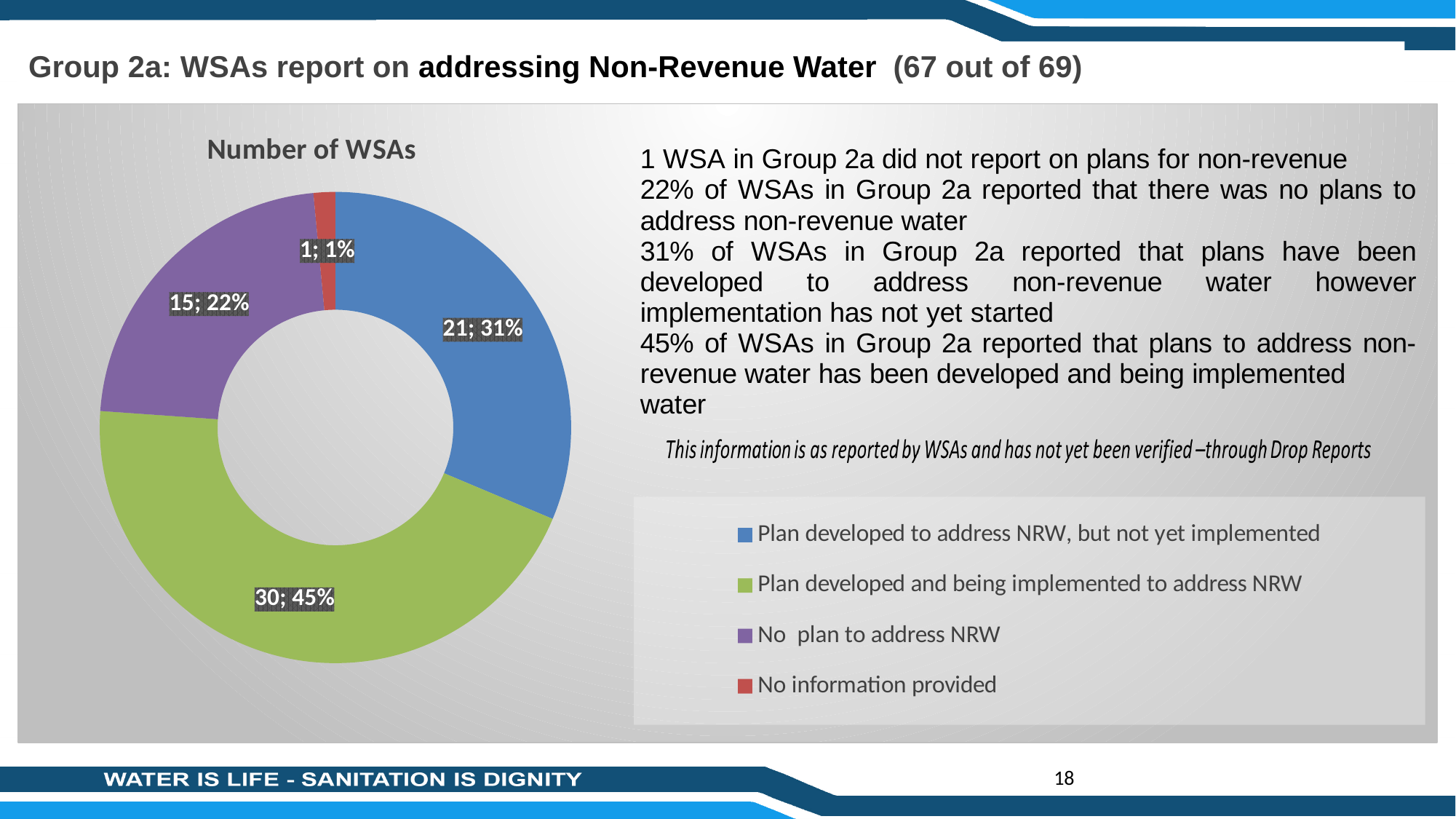
How many WSAs have a plan developed to address NRW but not yet implemented? 21 What share of the chart is 'No information provided'? 1% How many WSAs have a plan developed and being implemented to address NRW? 30 What is the title of the chart? Number of WSAs Which category has the largest slice? Plan developed and being implemented to address NRW How many categories does the legend list? 4 Which category has the smallest slice? No information provided What share of the chart is 'No plan to address NRW'? 22% How many WSAs have no plan to address NRW? 15 What is the difference between the number of WSAs with a plan being implemented and those with a plan not yet implemented? 9 Which colour represents 'No plan to address NRW'? Purple What type of chart is shown on the slide? Doughnut (pie) chart